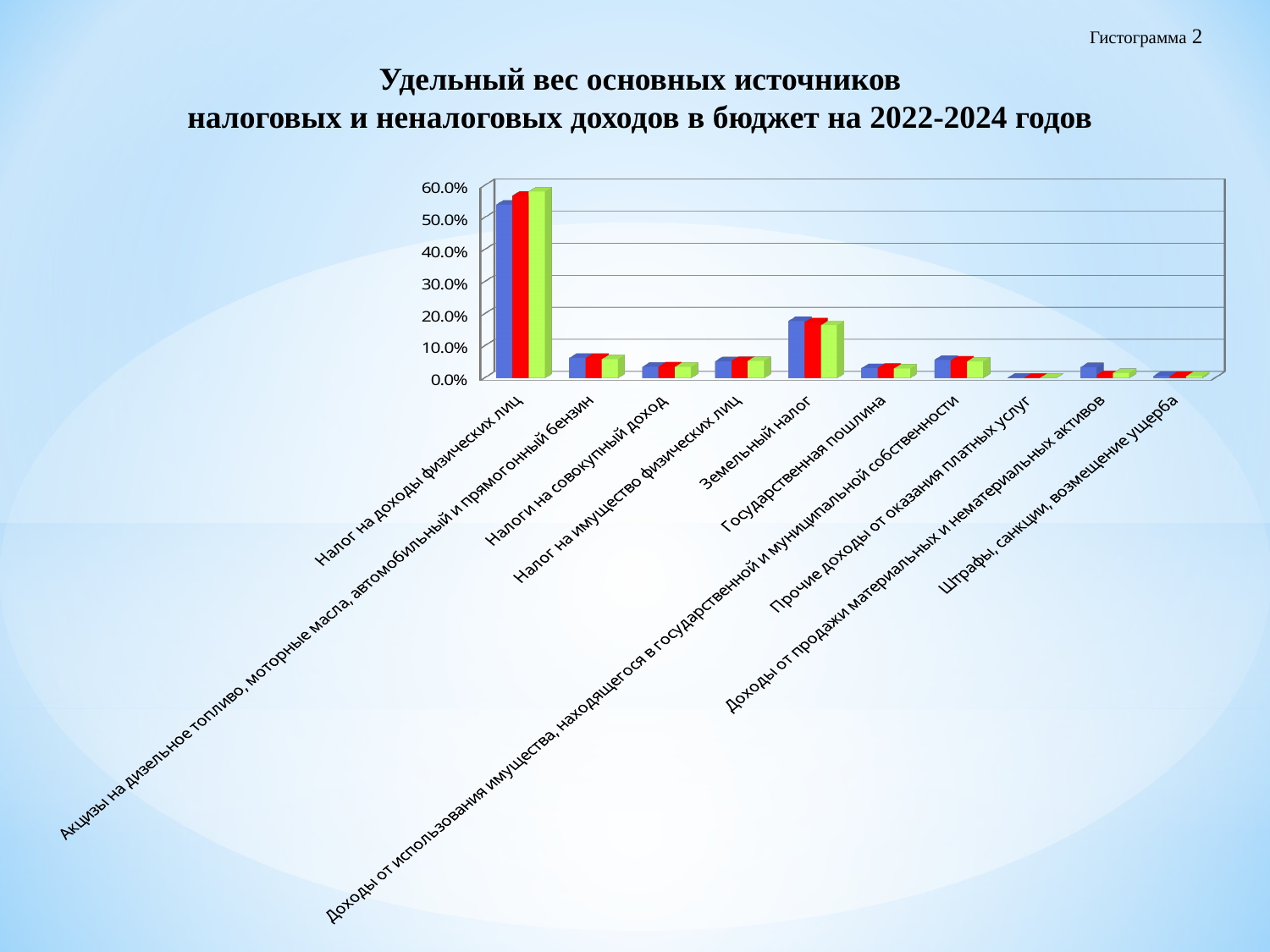
Which category has the highest values in the chart? Налог на доходы физических лиц Is the value for Налог на доходы физических лиц greater or less than 50.0%? greater Which is larger, the value for Налог на доходы физических лиц or the value for Земельный налог? Налог на доходы физических лиц Is the value for Земельный налог greater or less than 20.0%? less What is the highest value shown on the vertical axis of the chart? 60.0% Is the value for Земельный налог greater or less than 10.0%? greater How many categories are shown on the x axis of the chart? 10 What is the title of the chart on the slide? Удельный вес основных источников налоговых и неналоговых доходов в бюджет на 2022-2024 годов What kind of chart is shown on the slide? Bar chart Which is larger, the value for Земельный налог or the value for Налоги на совокупный доход? Земельный налог